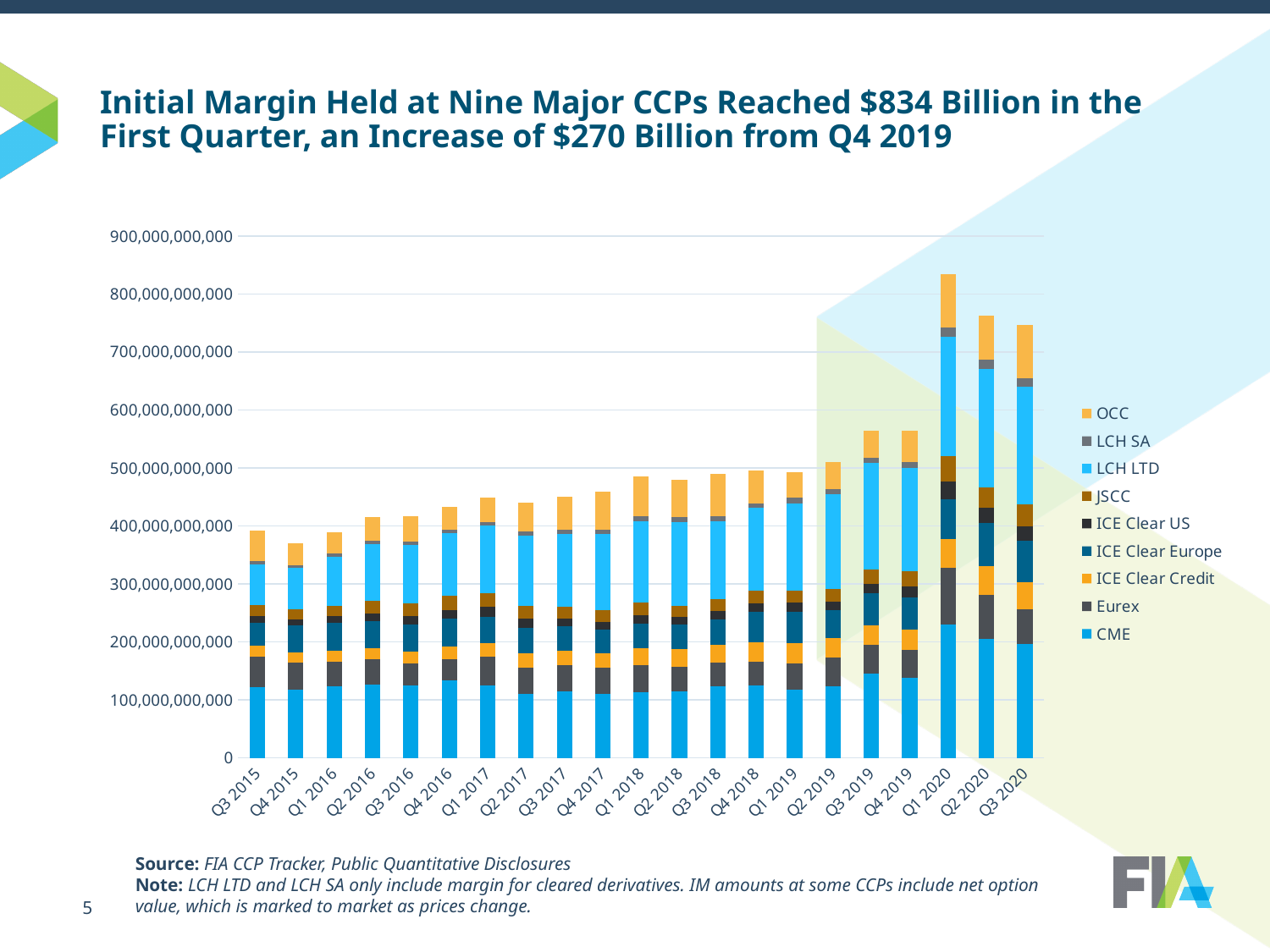
Do the total stacked values generally rise or fall from Q3 2015 to Q1 2020? rise What kind of chart is shown on the slide? Stacked bar chart How many quarters (bars) are plotted on the x axis? 21 How many series does the legend list? 9 Is the total stacked value for Q1 2020 greater or less than 800,000,000,000? greater Is the total stacked value for Q2 2020 greater or less than 700,000,000,000? greater Is the total stacked value for Q4 2015 greater or less than 400,000,000,000? less Which has the larger total stacked bar, Q4 2019 or Q1 2020? Q1 2020 Which quarter has the tallest stacked bar? Q1 2020 Which quarter has the shortest stacked bar? Q4 2015 Which series is listed first (at the top) in the legend? OCC